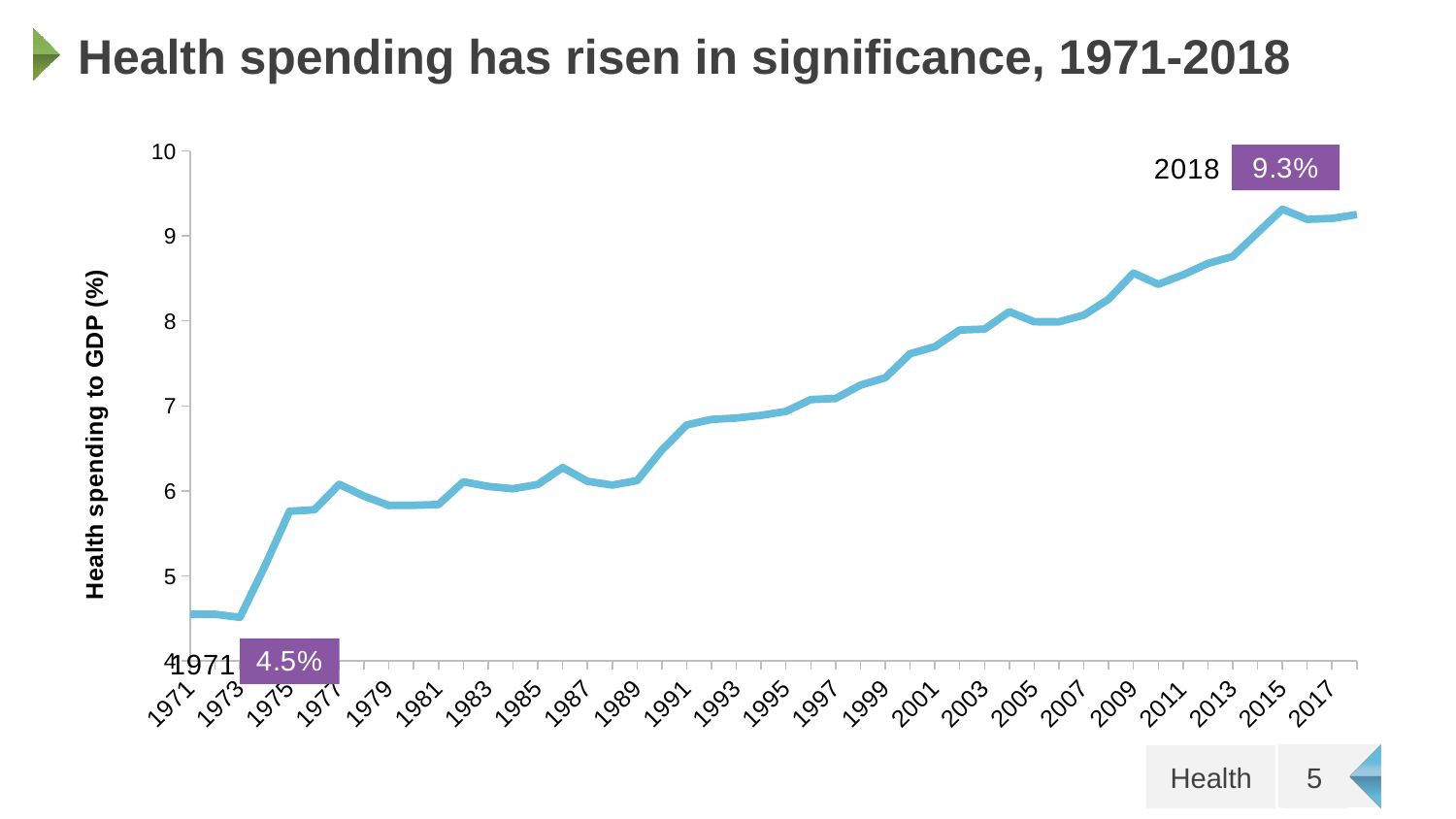
Is the value for 1991 greater or less than 6? greater What was health spending as a share of GDP in 2018? 9.3% Does health spending to GDP generally rise or fall from 1971 to 2018? rise Is the value for 2009 greater or less than 8? greater Is the value for 1981 greater or less than 6? less What is the label on the vertical axis of the chart? Health spending to GDP (%) By how many percentage points did health spending to GDP increase between 1971 and 2018? 4.8 percentage points Which year had the higher health spending to GDP, 1971 or 2018? 2018 What kind of chart is shown on the slide? line chart What was health spending as a share of GDP in 1971? 4.5%